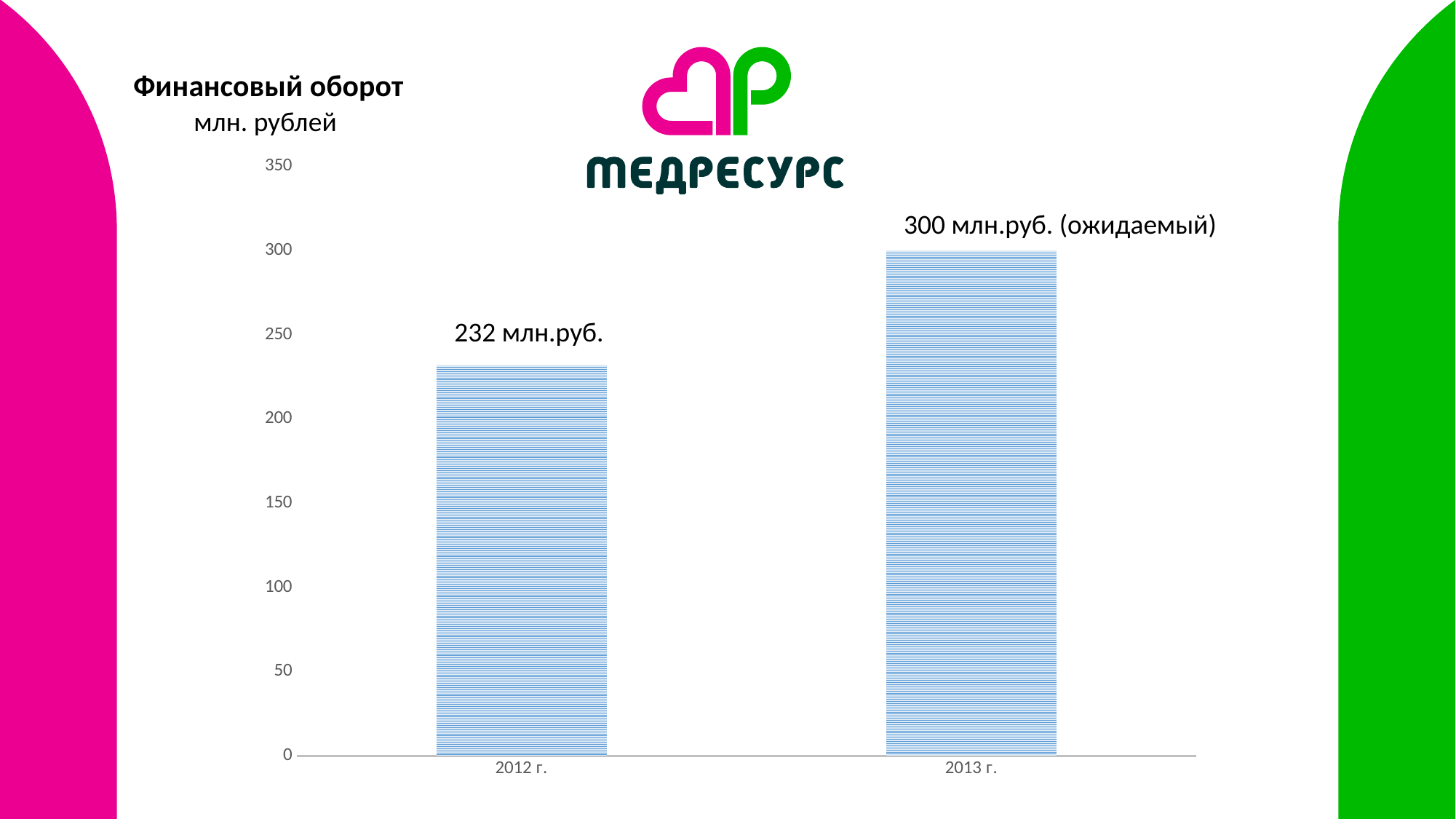
What unit is stated under the chart title? млн. рублей Do the values rise or fall from 2012 г. to 2013 г.? rise Which year has the highest value? 2013 г. What is the value for 2012 г.? 232 млн.руб. What kind of chart is shown on the slide? bar chart What is the title of the chart? Финансовый оборот How many categories are shown on the x axis? 2 Which is larger, the value for 2012 г. or 2013 г.? 2013 г. Which year has the lowest value? 2012 г. What is the value for 2013 г.? 300 млн.руб. (ожидаемый) Is the value for 2012 г. greater or less than 250? less What is the difference between the values for 2013 г. and 2012 г.? 68 млн.руб.